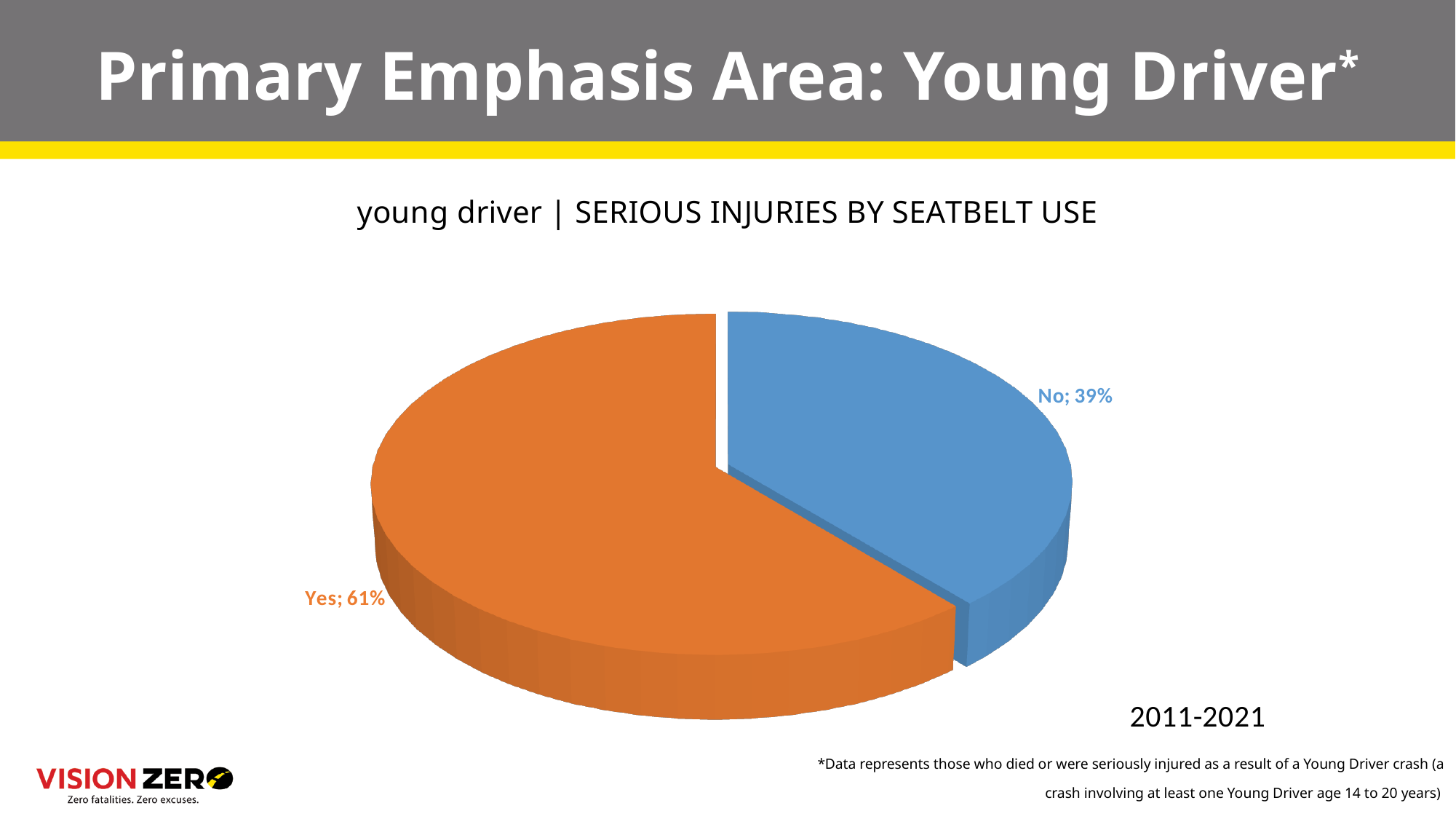
Which slice of the pie chart is the smallest? No What share of serious injuries is shown for the 'No' seatbelt use slice? 39% Which is larger, the 'Yes' slice or the 'No' slice? Yes What kind of chart is shown on the slide? Pie chart What colour is the 'No' slice of the pie chart? Blue What is the difference in percentage points between the 'Yes' and 'No' slices? 22 Which slice of the pie chart is the largest? Yes How many slices does the pie chart have? 2 What share of serious injuries is shown for the 'Yes' seatbelt use slice? 61% What is the share of the pie taken by the 'No' slice? 39% What is the title of the chart? young driver | SERIOUS INJURIES BY SEATBELT USE